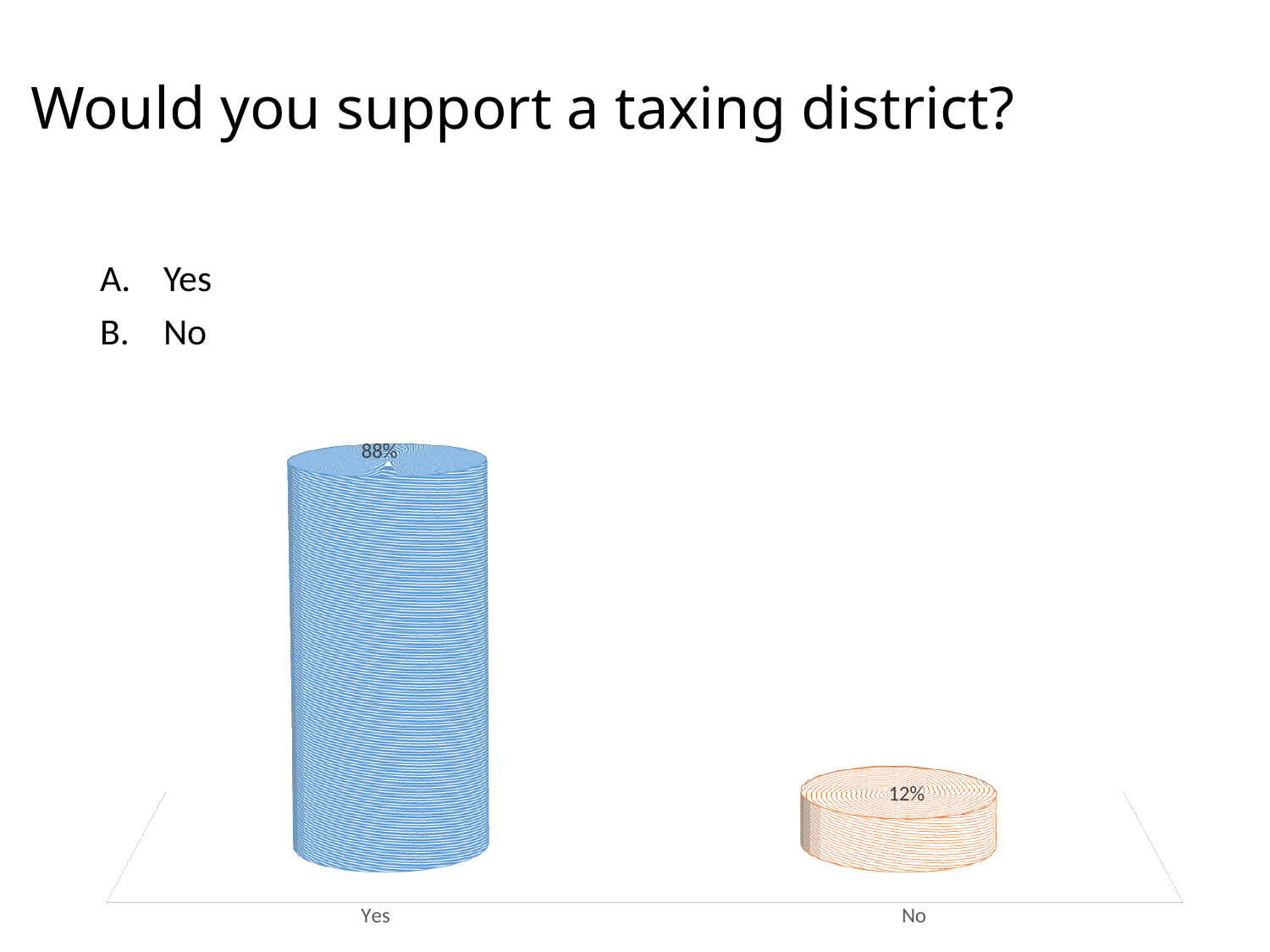
What colour is the bar for Yes? Blue Which category has the lowest value? No What is the difference between the values for Yes and No? 76% Which is larger, the value for Yes or the value for No? Yes What is the value for No? 12% Which category has the highest value? Yes What is the value for Yes? 88% What is the total of the values for Yes and No? 100% How many categories are shown in the chart? 2 What kind of chart is shown on the slide? Bar chart What colour is the bar for No? Orange